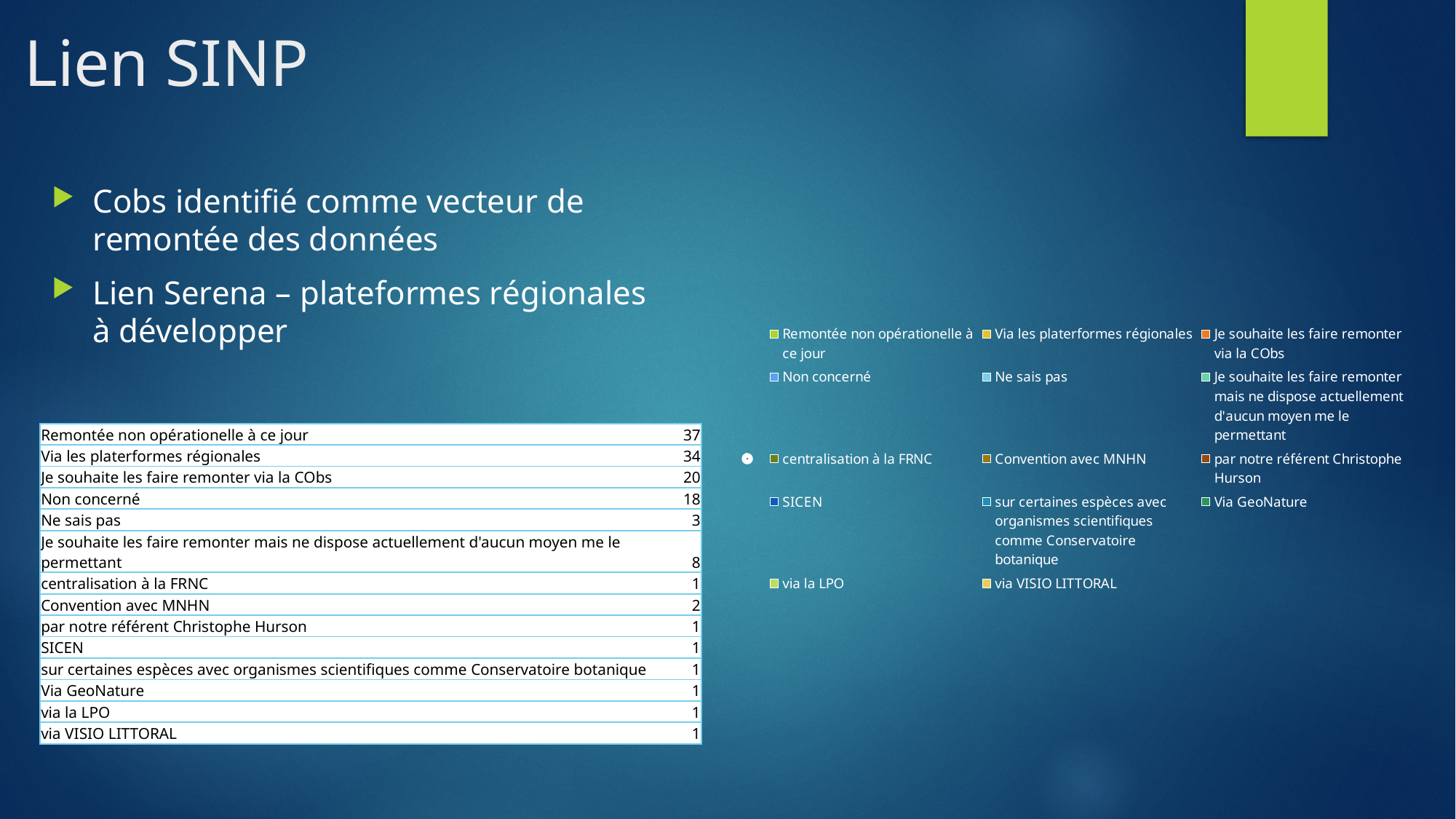
What is the first entry listed in the chart legend? Remontée non opérationelle à ce jour In the data table on the slide, what is the value for 'Via les platerformes régionales'? 34 How many entries does the chart legend on the right of the slide list? 14 In the data table on the slide, which category has the highest value? Remontée non opérationelle à ce jour In the data table on the slide, what is the value for 'Remontée non opérationelle à ce jour'? 37 In the data table on the slide, which is larger: the value for 'Non concerné' or the value for 'Ne sais pas'? Non concerné What is the last entry listed in the chart legend? via VISIO LITTORAL In the data table on the slide, what is the value for 'Convention avec MNHN'? 2 In the data table on the slide, what is the difference between the values for 'Remontée non opérationelle à ce jour' and 'Via les platerformes régionales'? 3 In the data table on the slide, what is the value for 'Ne sais pas'? 3 In the data table on the slide, what is the value for 'Je souhaite les faire remonter via la CObs'? 20 In the data table on the slide, what is the value for 'Non concerné'? 18